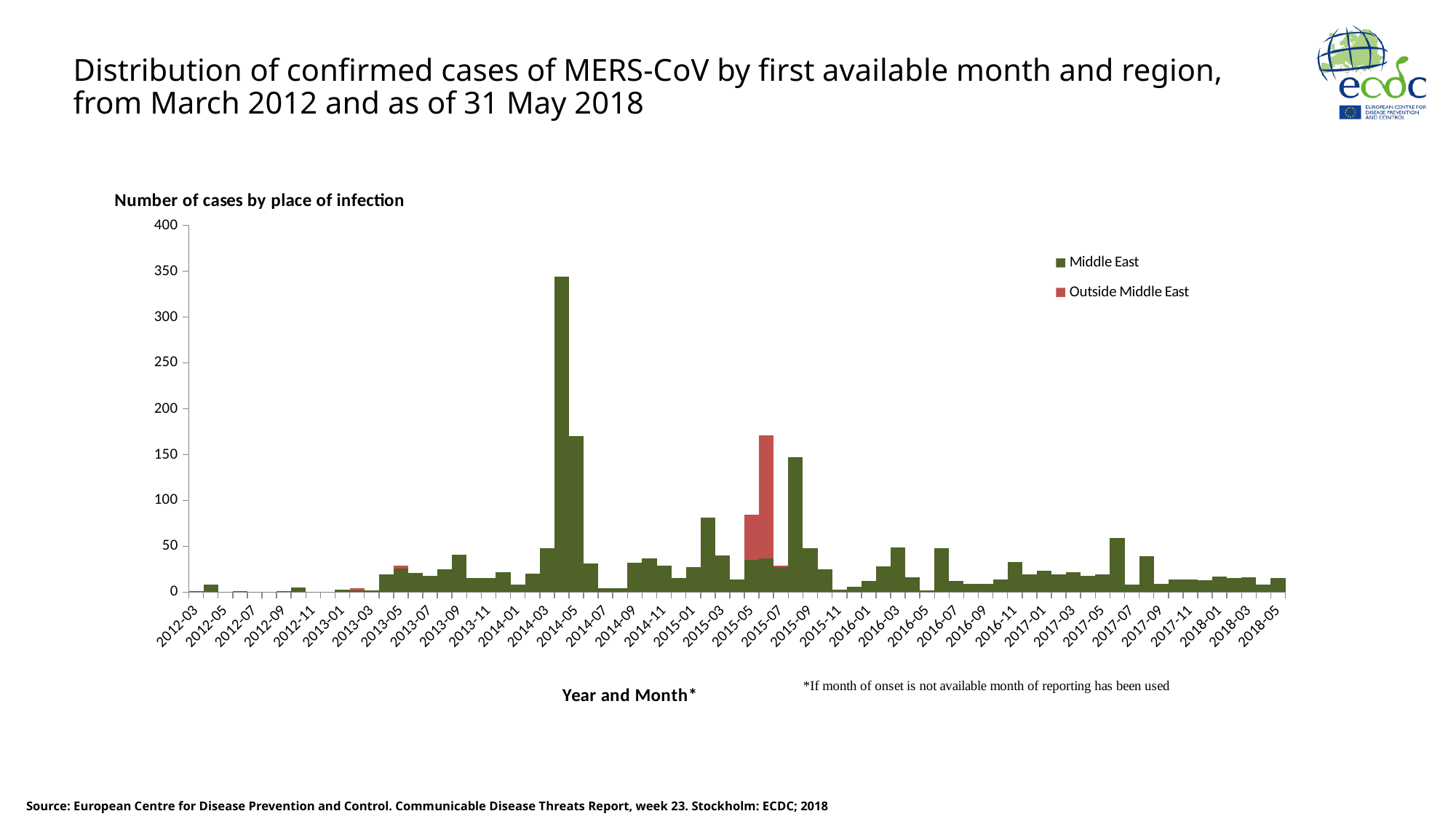
Which is larger, the value for 2015-03 or the value for 2016-03? 2016-03 Which series accounts for the tallest bar in the chart? Middle East Is the value for 2012-05 greater or less than 50? less What is the title of the vertical axis? Number of cases by place of infection What kind of chart is shown on the slide? Stacked bar chart What are the two series named in the legend? Middle East and Outside Middle East Do the values rise or fall from 2014-05 to 2014-07? fall Is the tallest bar in the chart greater or less than 300? greater Is the value for 2015-03 greater or less than 100? less How many series does the legend list? 2